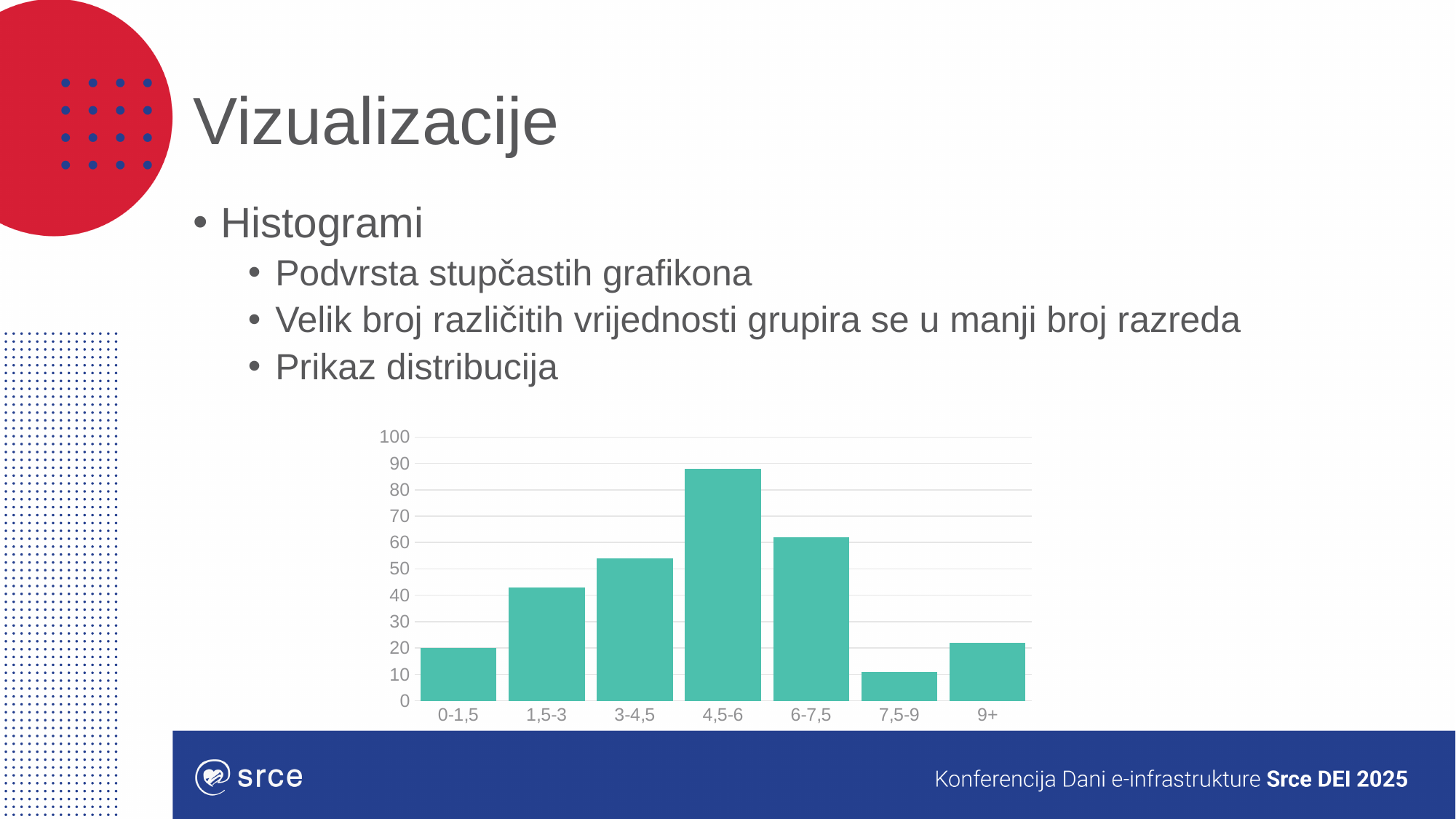
What kind of chart is shown on the slide? bar chart (histogram) How many bins (categories) are shown on the x axis of the histogram? 7 Which bin has the larger value, 0-1,5 or 1,5-3? 1,5-3 Is the value for the 3-4,5 bin greater or less than 50? greater Do the bar values rise or fall from the 4,5-6 bin to the 7,5-9 bin? fall Is the value for the 7,5-9 bin greater or less than 20? less Which bin has the highest bar in the histogram? 4,5-6 Is the value for the 4,5-6 bin greater or less than 80? greater Which bin has the lowest bar in the histogram? 7,5-9 Which bin has the larger value, 3-4,5 or 6-7,5? 6-7,5